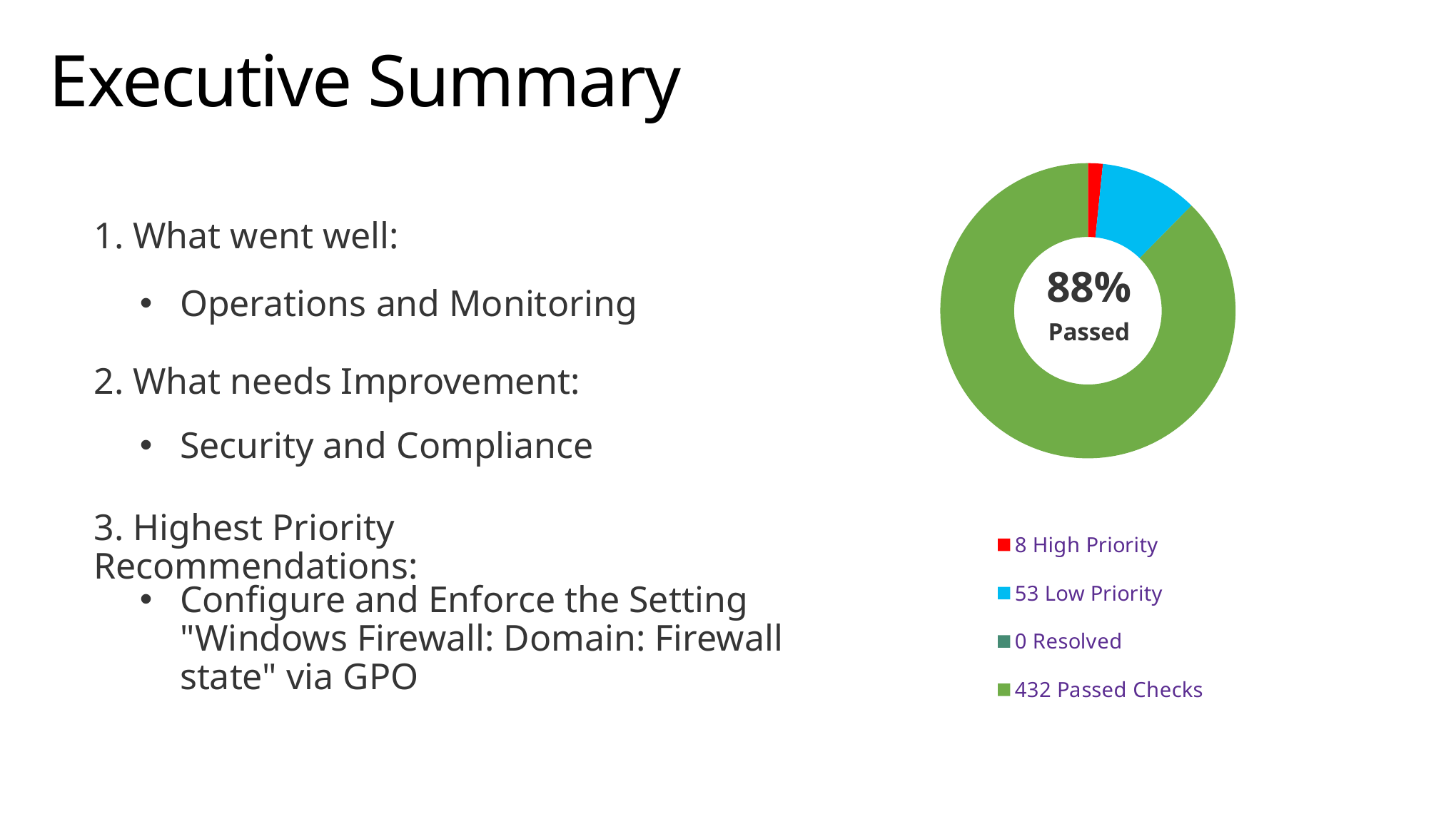
How many categories does the legend of the donut chart list? 4 Which is larger, the Low Priority count or the High Priority count? Low Priority Which category has the largest value in the donut chart? Passed Checks How many checks are in the High Priority category? 8 What is the difference between the Low Priority and High Priority counts? 45 What colour represents the Passed Checks slice in the donut chart? Green How many Passed Checks are shown in the legend? 432 How many checks are in the Low Priority category? 53 Which category has the smallest value in the donut chart? Resolved How many checks are in the Resolved category? 0 What kind of chart is shown on the slide? Donut chart What percentage is shown in the centre of the donut chart as Passed? 88%